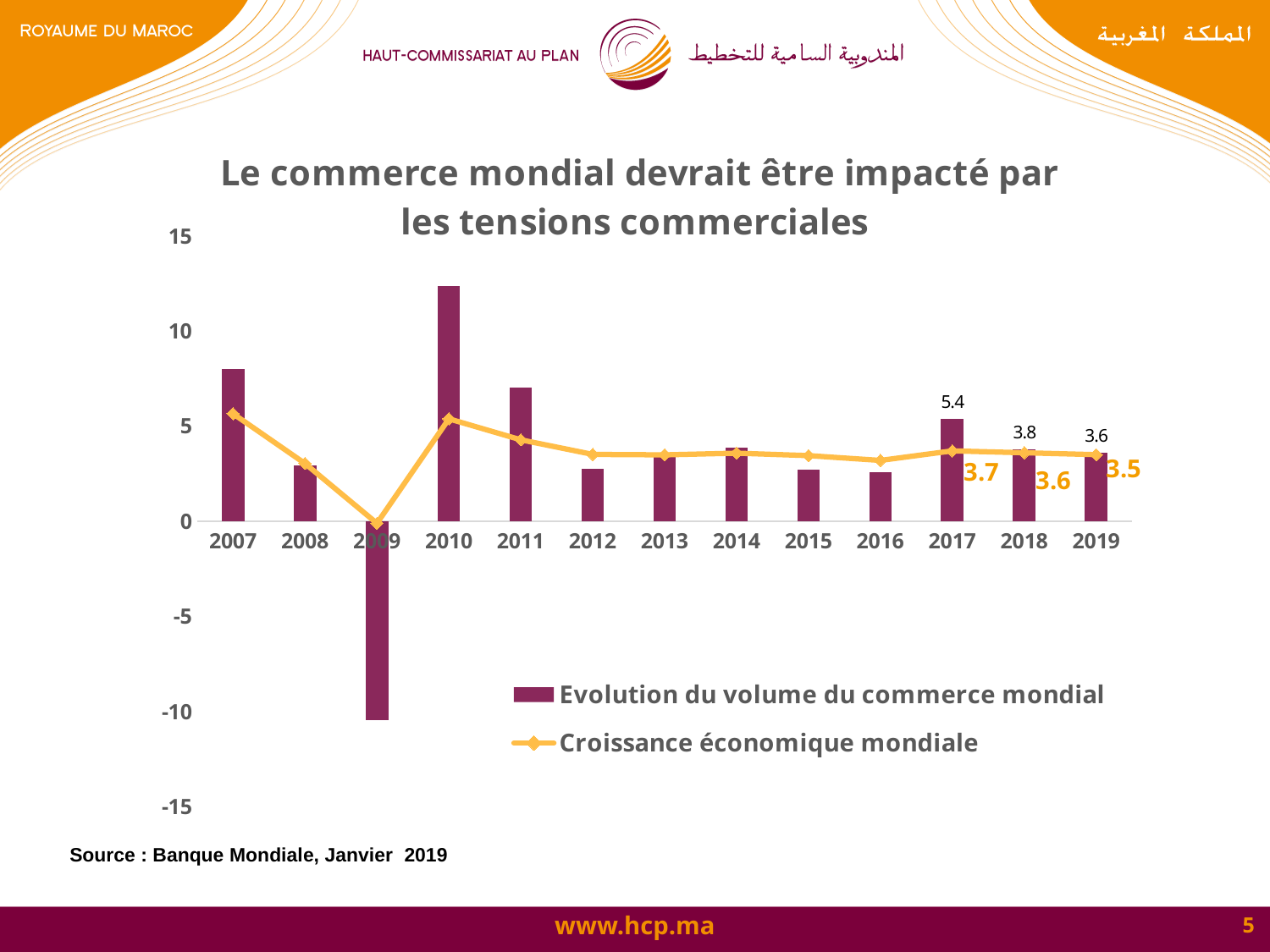
How many years are shown on the x axis? 13 Does Croissance économique mondiale rise or fall from 2017 to 2019? fall What is the value of Evolution du volume du commerce mondial for 2017? 5.4 What is the difference between Evolution du volume du commerce mondial in 2017 and in 2018? 1.6 Is the value of Evolution du volume du commerce mondial for 2010 greater or less than 10? greater What is the value of Croissance économique mondiale for 2017? 3.7 In which year is Evolution du volume du commerce mondial highest? 2010 In which year is Evolution du volume du commerce mondial lowest? 2009 What is the value of Evolution du volume du commerce mondial for 2018? 3.8 Which is larger in 2018: Evolution du volume du commerce mondial or Croissance économique mondiale? Evolution du volume du commerce mondial How many series does the legend list? 2 What is the value of Croissance économique mondiale for 2019? 3.5